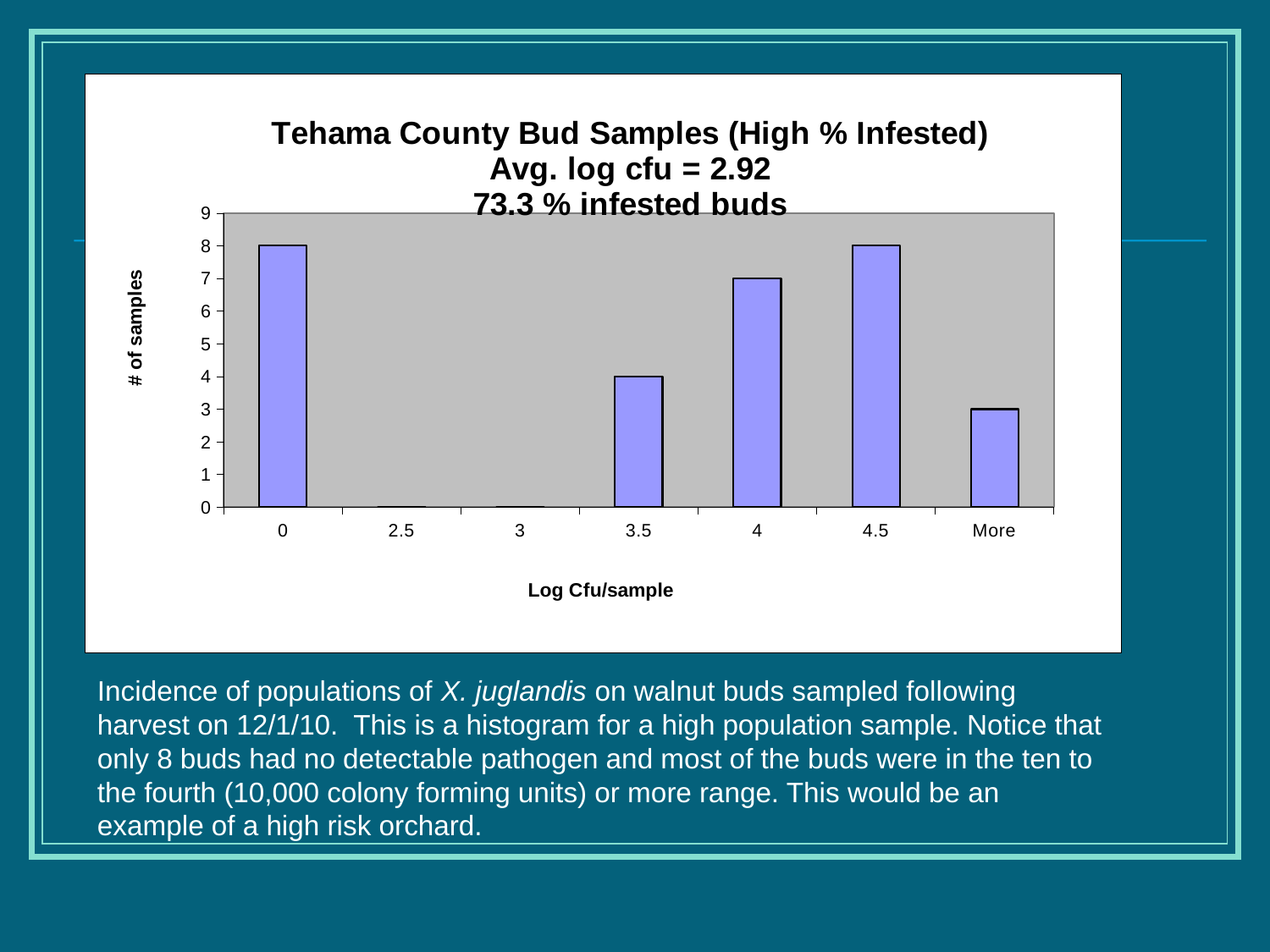
What is the number of samples for the 0 log cfu/sample category? 8 What is the number of samples for the 'More' category? 3 What is the difference in number of samples between the 4.5 category and the 'More' category? 5 Is the number of samples for the 4 category greater or less than 5? greater How many categories are shown on the x axis of the chart? 7 What kind of chart is shown on the slide? bar chart Is the number of samples for the 'More' category greater or less than 5? less What is the number of samples for the 3.5 log cfu/sample category? 4 What is the number of samples for the 4 log cfu/sample category? 7 What is the label of the x axis of the chart? Log Cfu/sample Which has more samples, the 4 category or the 3.5 category? 4 What average log cfu value is stated in the chart title? 2.92